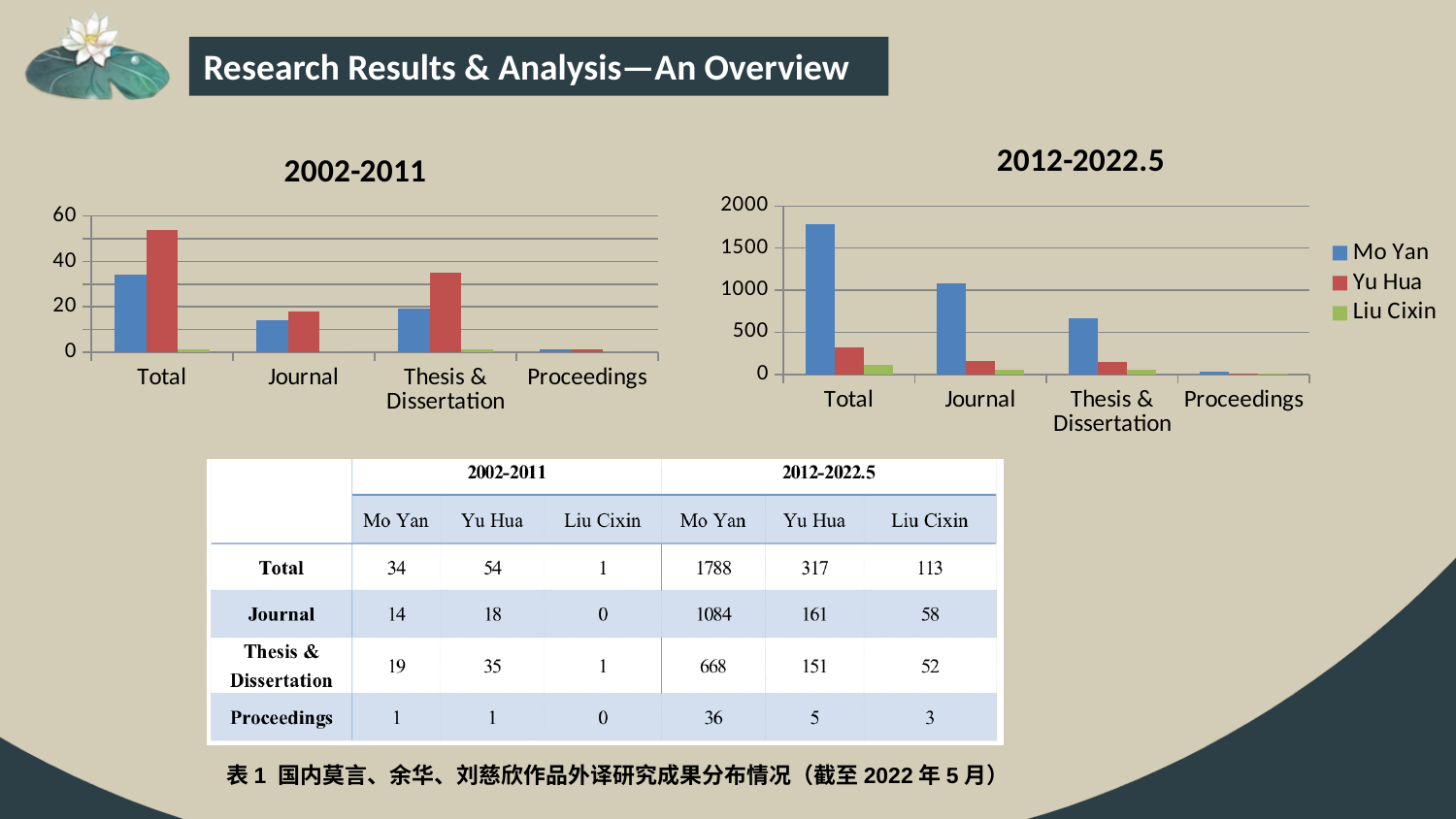
In the 2012-2022.5 chart, is the value for Mo Yan in the Thesis & Dissertation category greater or less than 500? greater In the 2002-2011 chart, what is the value for Yu Hua in the Total category? 54 In the 2012-2022.5 chart, what is the value for Mo Yan in the Journal category? 1084 How many series does the legend of the 2012-2022.5 chart list? 3 How many categories are shown on the x axis of the 2002-2011 chart? 4 What kind of chart is the 2002-2011 chart? bar chart In the 2012-2022.5 chart, do the values for Mo Yan rise or fall from Total to Proceedings along the x axis? fall In the 2012-2022.5 chart, which series has the highest value in the Total category? Mo Yan In the 2002-2011 chart, which category has the lowest value for Yu Hua? Proceedings In the 2002-2011 chart, which is larger in the Thesis & Dissertation category, Mo Yan or Yu Hua? Yu Hua In the 2012-2022.5 chart, what is the difference between Mo Yan and Yu Hua in the Total category? 1471 What colour represents Liu Cixin in the 2012-2022.5 chart legend? green